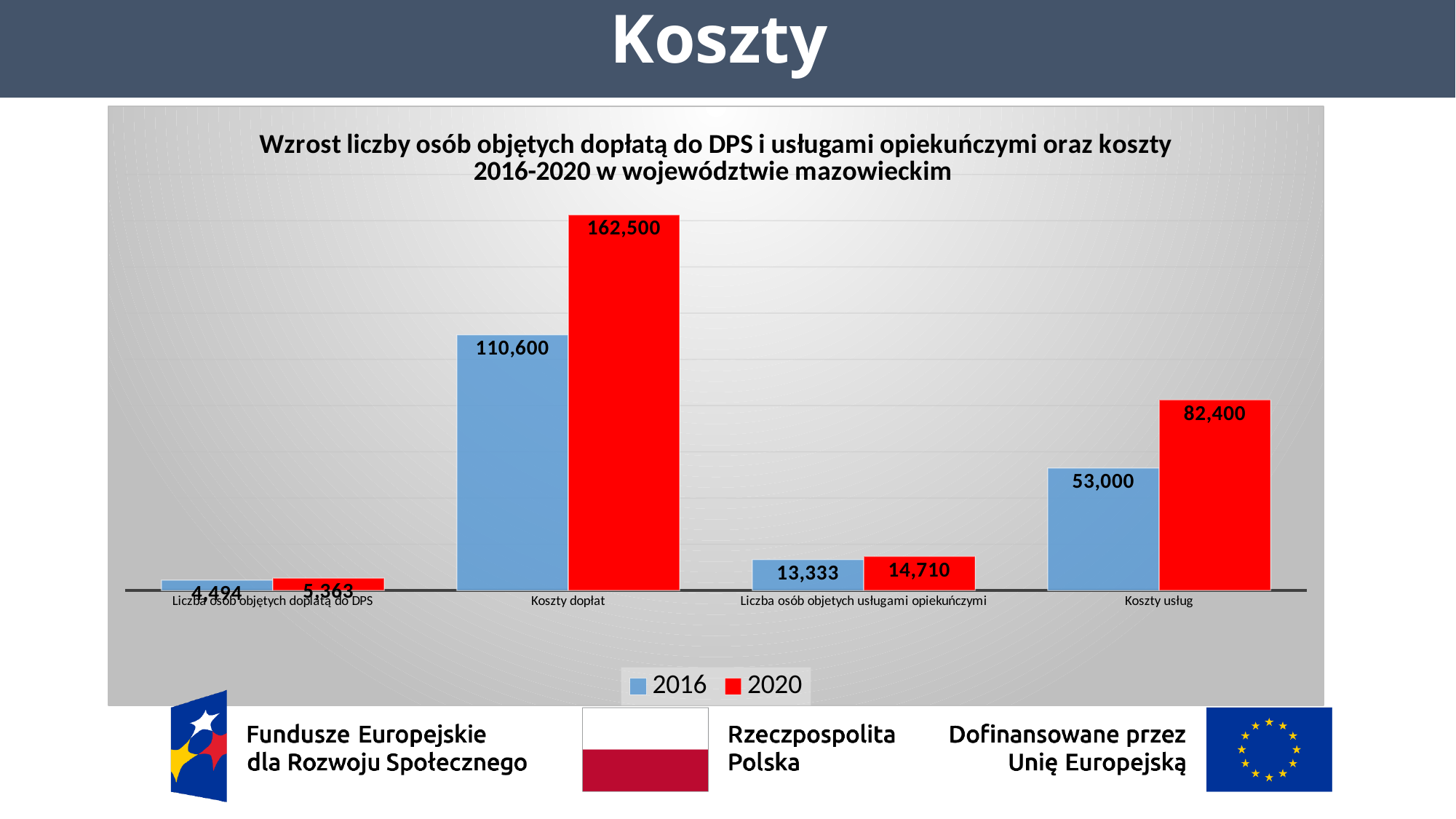
How many series does the legend list? 2 Which category has the lowest value in the 2016 series? Liczba osób objętych dopłatą do DPS Which category has the highest value in the 2020 series? Koszty dopłat How many categories are shown on the x axis? 4 What is the value for Koszty usług in 2016? 53,000 What is the difference between the 2020 and 2016 values for Koszty usług? 29,400 What is the difference between the 2020 and 2016 values for Koszty dopłat? 51,900 What is the 2020 value for Liczba osób objętych usługami opiekuńczymi? 14,710 What kind of chart is shown on the slide? Bar chart What is the value for Koszty dopłat in 2020? 162,500 Which is larger: the 2016 value for Koszty usług or the 2016 value for Koszty dopłat? Koszty dopłat What is the 2016 value for Liczba osób objętych dopłatą do DPS? 4,494